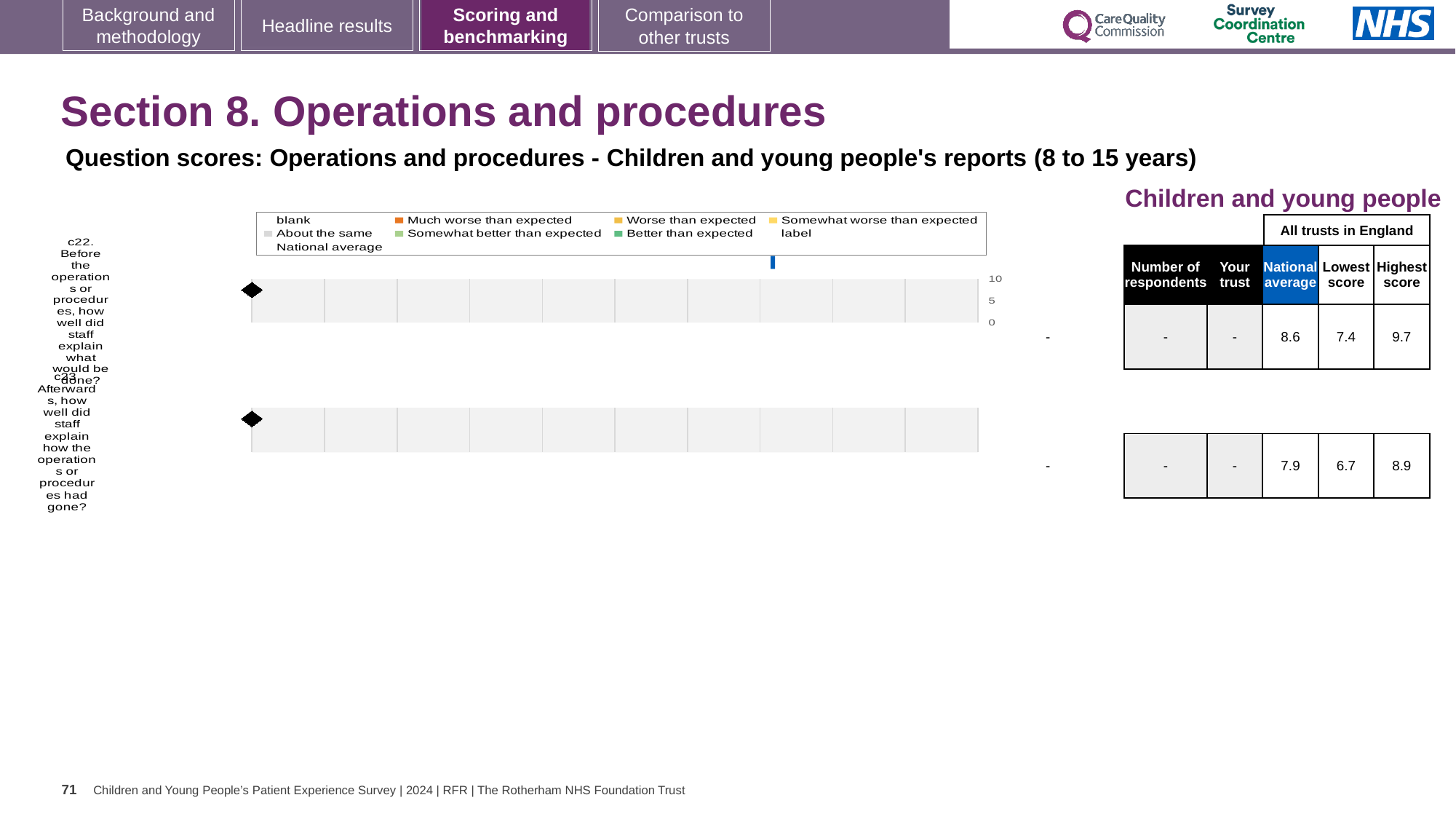
How many questions (categories) are listed on the chart's vertical axis? 2 What is the highest tick value shown on the chart's numeric axis? 10 In the table to the right of the chart, what is the Lowest score for c22? 7.4 In the table to the right of the chart, what is the National average score for c23? 7.9 In the table to the right of the chart, what is the Highest score for c23? 8.9 What kind of chart is shown on the slide? bar chart In the table to the right of the chart, what is the National average score for c22? 8.6 In the table to the right of the chart, what is the Lowest score for c23? 6.7 In the table to the right of the chart, what is the Highest score for c22? 9.7 In the table to the right of the chart, what is the difference between the Highest score and the Lowest score for c23? 2.2 In the table to the right of the chart, which question has the higher National average, c22 or c23? c22 Which question label appears first (at the top) on the chart's vertical axis? c22. Before the operations or procedures, how well did staff explain what would be done?